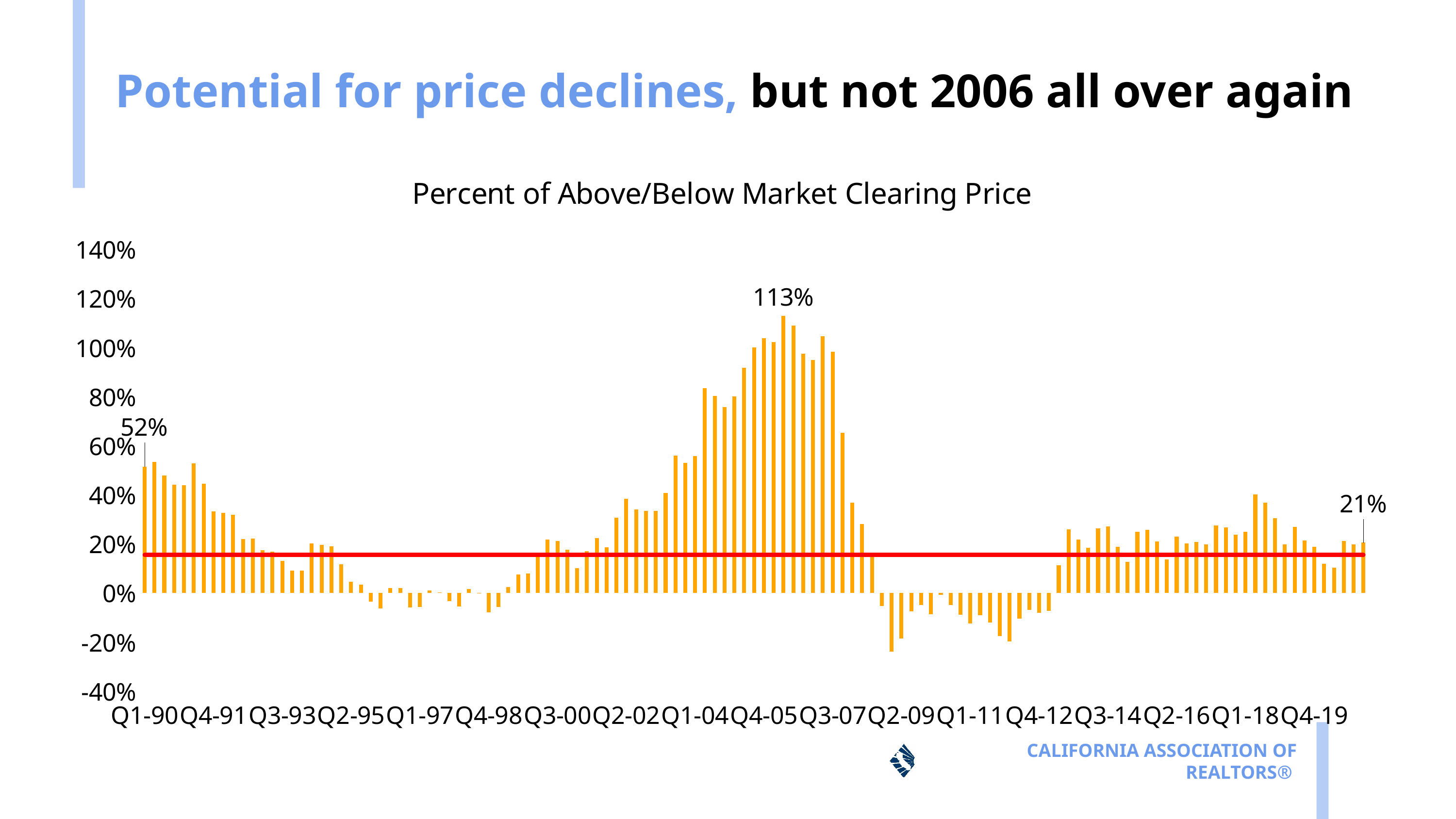
Is the lowest bar on the chart (around 2009) greater or less than 0%? less Do the values rise or fall from Q1-90 to Q3-93? fall What kind of chart is shown on the slide? bar and line chart What is the difference between the peak value of 113% and the last bar's value of 21%? 92% What is the value of the first bar (Q1-90) in the chart? 52% Is the peak value of the chart greater or less than 100%? greater What is the highest value labeled on the chart? 113% What is the maximum value shown on the vertical axis? 140% What is the value labeled on the last bar of the chart? 21% What is the title of the chart? Percent of Above/Below Market Clearing Price What is the difference between the Q1-90 value and the last bar's value? 31% Which is larger: the value for Q1-90 or the value of the last bar? Q1-90